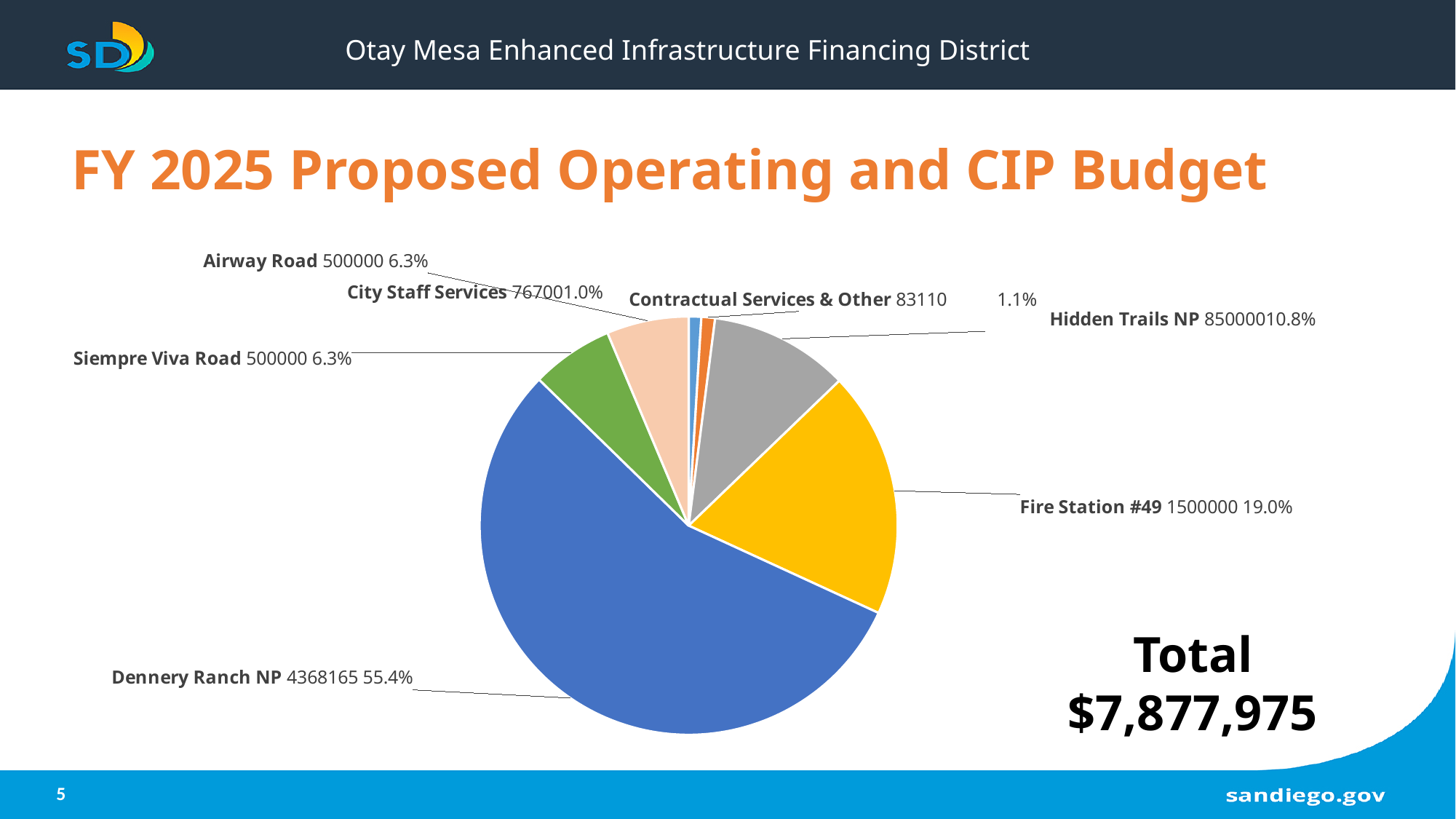
Which is larger, Fire Station #49 or Airway Road? Fire Station #49 How many slices does the pie chart have? 7 What total amount is shown next to the pie chart? $7,877,975 What is the difference between the values for Fire Station #49 and Airway Road? 1000000 What share of the pie does Fire Station #49 represent? 19.0% What share of the pie does Dennery Ranch NP represent? 55.4% What kind of chart is shown on the slide? pie chart What is the value for Contractual Services & Other? 83110 What is the value for Fire Station #49? 1500000 What share of the pie does Airway Road represent? 6.3% Which category has the largest slice of the pie? Dennery Ranch NP What is the value for Siempre Viva Road? 500000